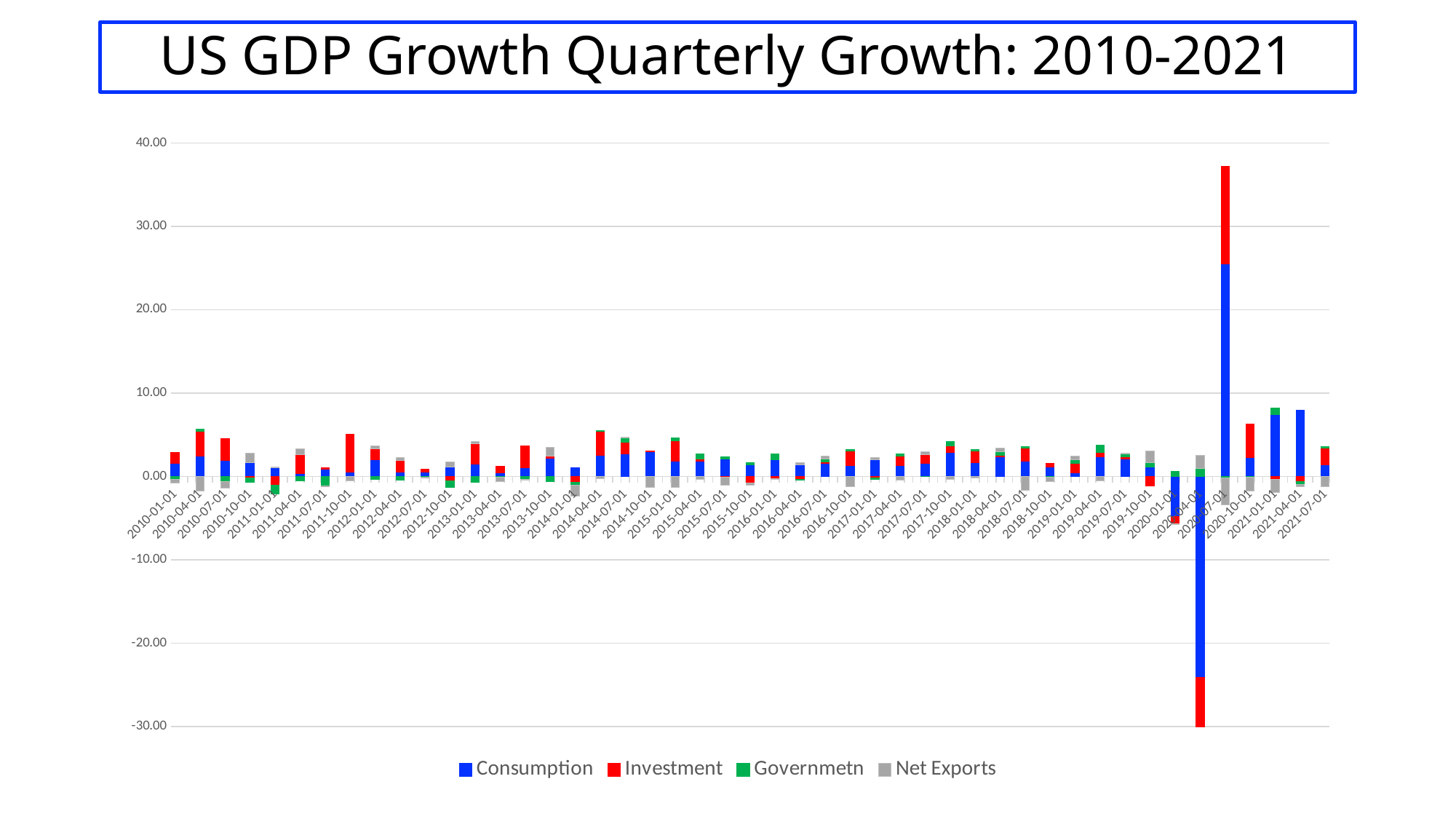
Is the Consumption value for 2020-04-01 greater or less than -20? less What kind of chart is shown on the slide? Stacked bar chart Is the top of the stacked bar for 2020-07-01 greater or less than 30? greater What is the title of the chart? US GDP Growth Quarterly Growth: 2010-2021 Is the Consumption value for 2020-07-01 greater or less than 20? greater Which quarter has the tallest positive stacked bar? 2020-07-01 How many quarters (categories) are plotted on the x axis? 47 Which quarter has the lowest (most negative) stacked bar? 2020-04-01 Which is larger, the Consumption value for 2020-07-01 or for 2021-04-01? 2020-07-01 Which series is shown in blue in the legend? Consumption How many series does the legend list? 4